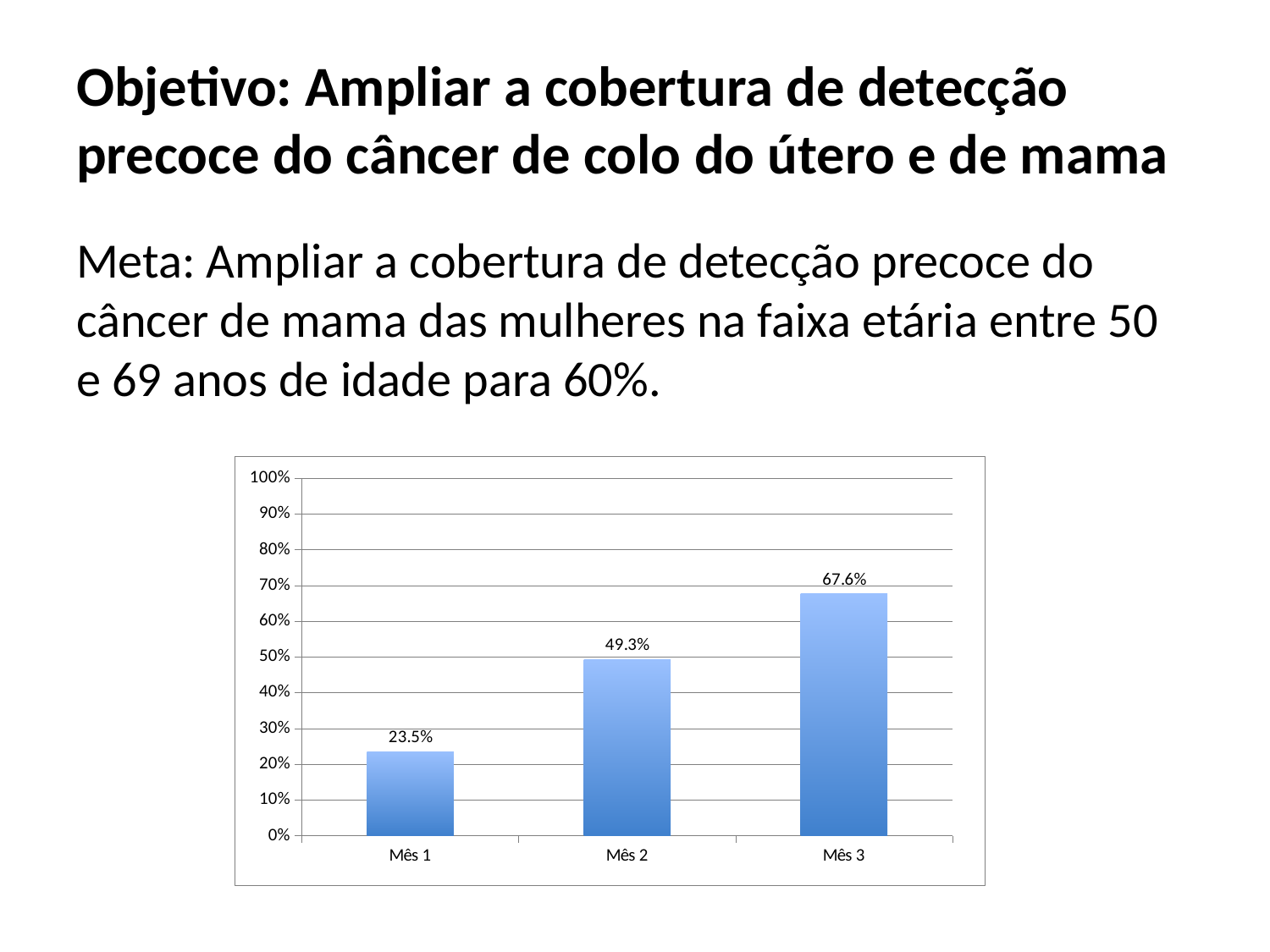
What kind of chart is shown on the slide? bar chart What is the value for Mês 3? 67.6% Which month has the highest value? Mês 3 How many categories are shown on the x axis? 3 Which is larger, the value for Mês 2 or the value for Mês 3? Mês 3 What is the value for Mês 2? 49.3% What is the difference between the values for Mês 3 and Mês 1? 44.1% What is the value for Mês 1? 23.5% Do the values rise or fall from Mês 1 to Mês 3? rise What is the difference between the values for Mês 2 and Mês 1? 25.8% Is the value for Mês 3 greater or less than 60%? greater Which month has the lowest value? Mês 1